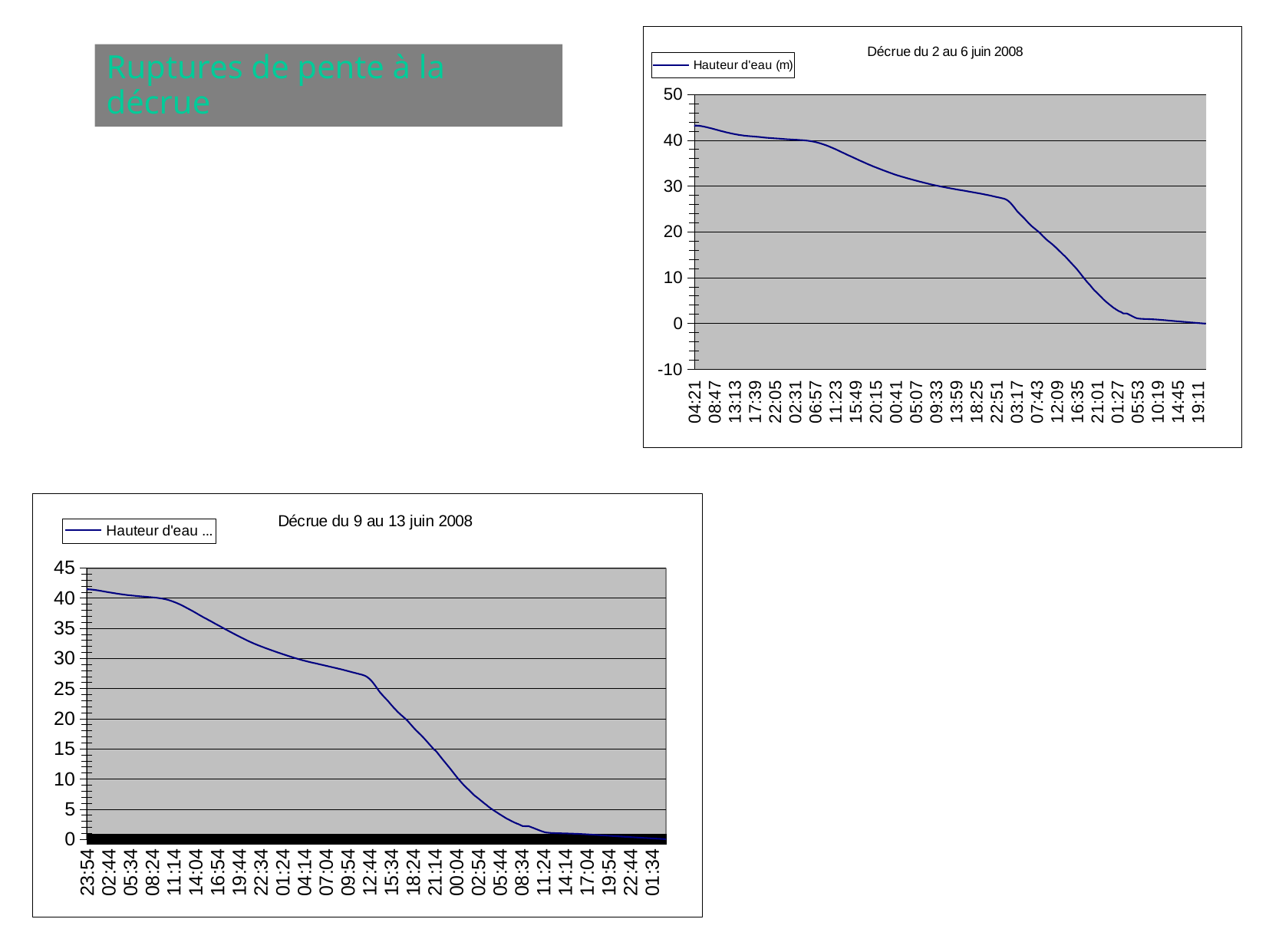
In the chart 'Décrue du 9 au 13 juin 2008', is the value at 14:04 greater or less than 35? greater What kind of chart is 'Décrue du 2 au 6 juin 2008'? line chart What kind of chart is 'Décrue du 9 au 13 juin 2008'? line chart In the chart 'Décrue du 2 au 6 juin 2008', do the values rise or fall along the x axis? fall In the chart 'Décrue du 2 au 6 juin 2008', is the value at 16:35 greater or less than 10? greater What is the legend entry of the chart 'Décrue du 2 au 6 juin 2008'? Hauteur d'eau (m) In the chart 'Décrue du 9 au 13 juin 2008', is the value at 19:44 greater or less than 35? less In the chart 'Décrue du 9 au 13 juin 2008', do the values rise or fall along the x axis? fall How many series does the legend of 'Décrue du 2 au 6 juin 2008' list? 1